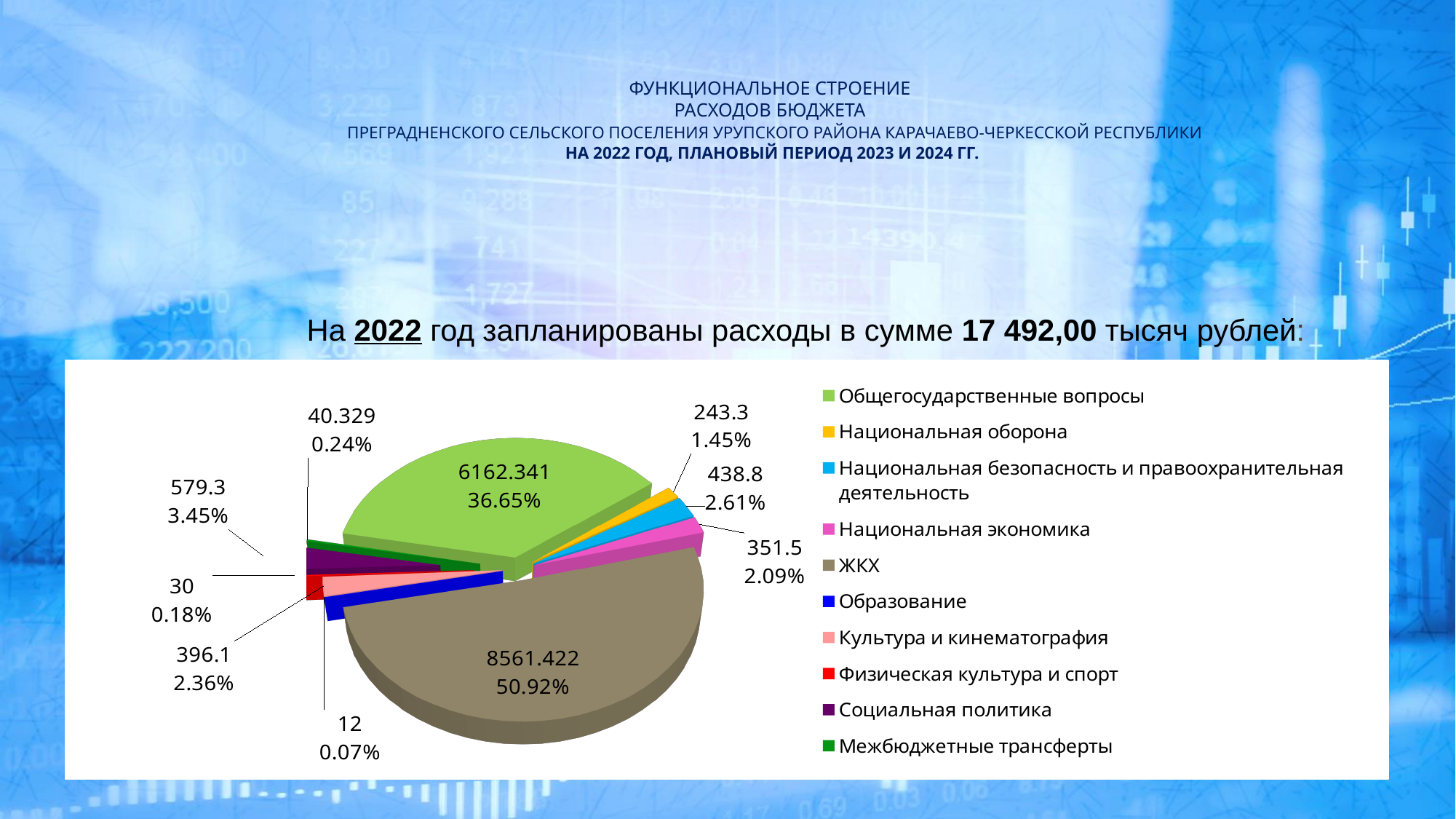
What is the difference between the values for ЖКХ and Общегосударственные вопросы? 2399.081 Which category has the largest slice of the pie? ЖКХ What is the value shown for Национальная экономика? 351.5 Which is larger: the value for Национальная безопасность и правоохранительная деятельность or for Национальная оборона? Национальная безопасность и правоохранительная деятельность What share of the pie is Национальная безопасность и правоохранительная деятельность? 2.61% How many categories does the legend of the pie chart list? 10 What is the value shown for Общегосударственные вопросы? 6162.341 What kind of chart is shown on the slide? pie chart What is the value shown for Национальная оборона? 243.3 What is the value shown for ЖКХ in the pie chart? 8561.422 What share of the pie does ЖКХ represent? 50.92% What percentage of the pie is Общегосударственные вопросы? 36.65%